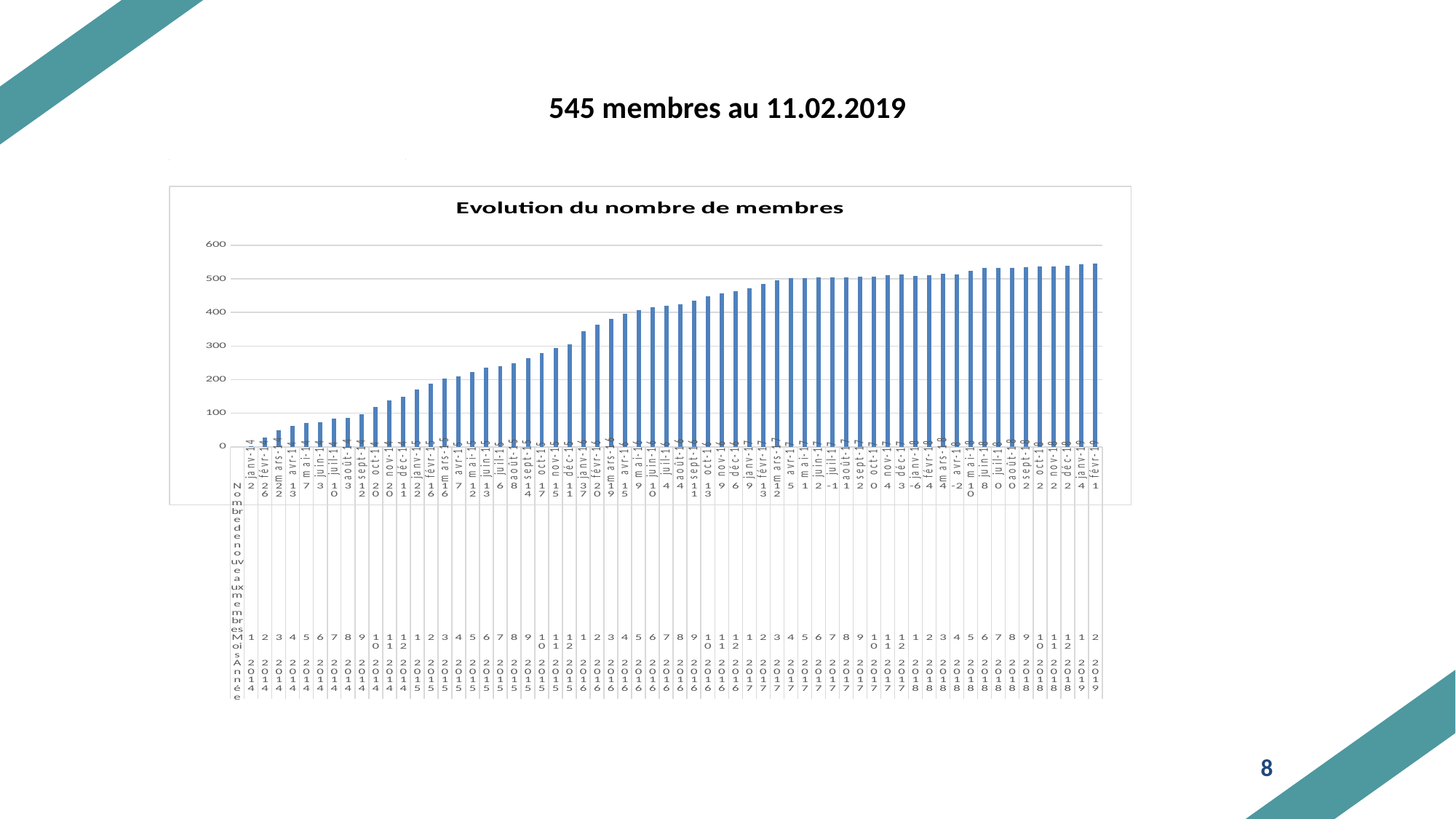
What is the highest value shown on the vertical axis of the chart? 600 Is the value for janv-14 greater or less than 100? less Which month has the lowest value in the chart? janv-14 Is the value for janv-16 greater or less than 300? greater Is the value for févr-19 greater or less than 500? greater What is the title of the chart? Evolution du nombre de membres What kind of chart is shown on the slide? bar chart How many monthly bars are plotted in the chart? 62 Which is larger, the value for déc-14 or the value for déc-16? déc-16 Do the values in the chart rise or fall from left to right along the x axis? rise